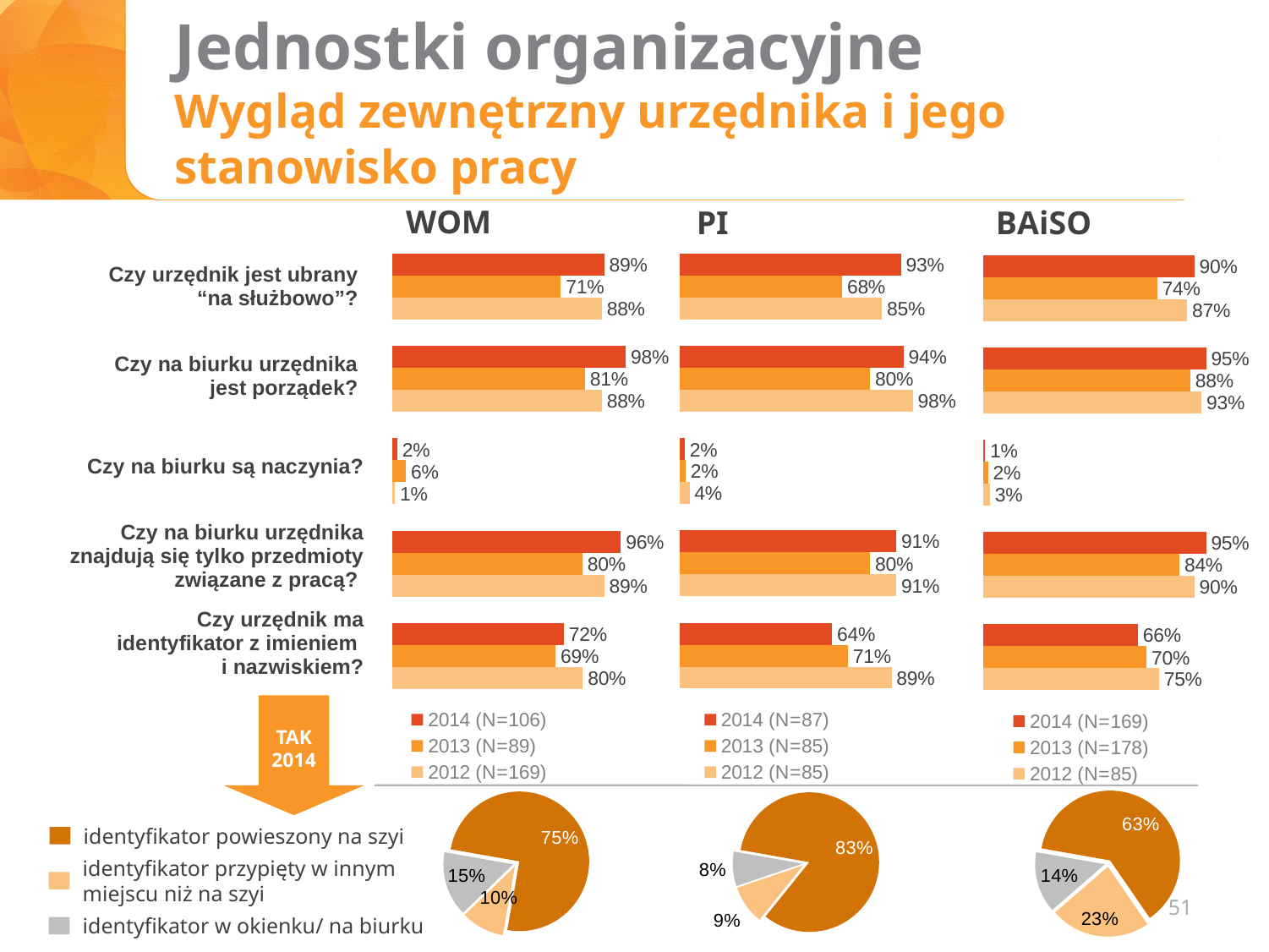
What type of chart is used for the WOM, PI and BAiSO data in the upper part of the slide? bar chart In the BAiSO bar chart, which is larger for "Czy na biurku urzędnika jest porządek?": the 2014 value or the 2012 value? 2014 How many questions (categories) are shown in the WOM bar chart? 5 In the PI bar chart, what is the 2012 value for "Czy urzędnik ma identyfikator z imieniem i nazwiskiem?"? 89% In the BAiSO pie chart at the bottom, what share is "identyfikator przypięty w innym miejscu niż na szyi"? 23% In the PI bar chart, what is the difference between the 2014 and 2013 values for "Czy urzędnik jest ubrany "na służbowo"?"? 25% In the WOM bar chart, which question has the lowest 2014 value? Czy na biurku są naczynia? What sample size (N) does the legend of the BAiSO bar chart give for 2013? N=178 How many series does the legend of the PI bar chart list? 3 In the WOM bar chart, what is the 2014 value for "Czy na biurku urzędnika jest porządek?"? 98% In the BAiSO bar chart, what is the 2013 value for "Czy urzędnik jest ubrany "na służbowo"?"? 74% In the WOM pie chart at the bottom, what share is "identyfikator powieszony na szyi"? 75%